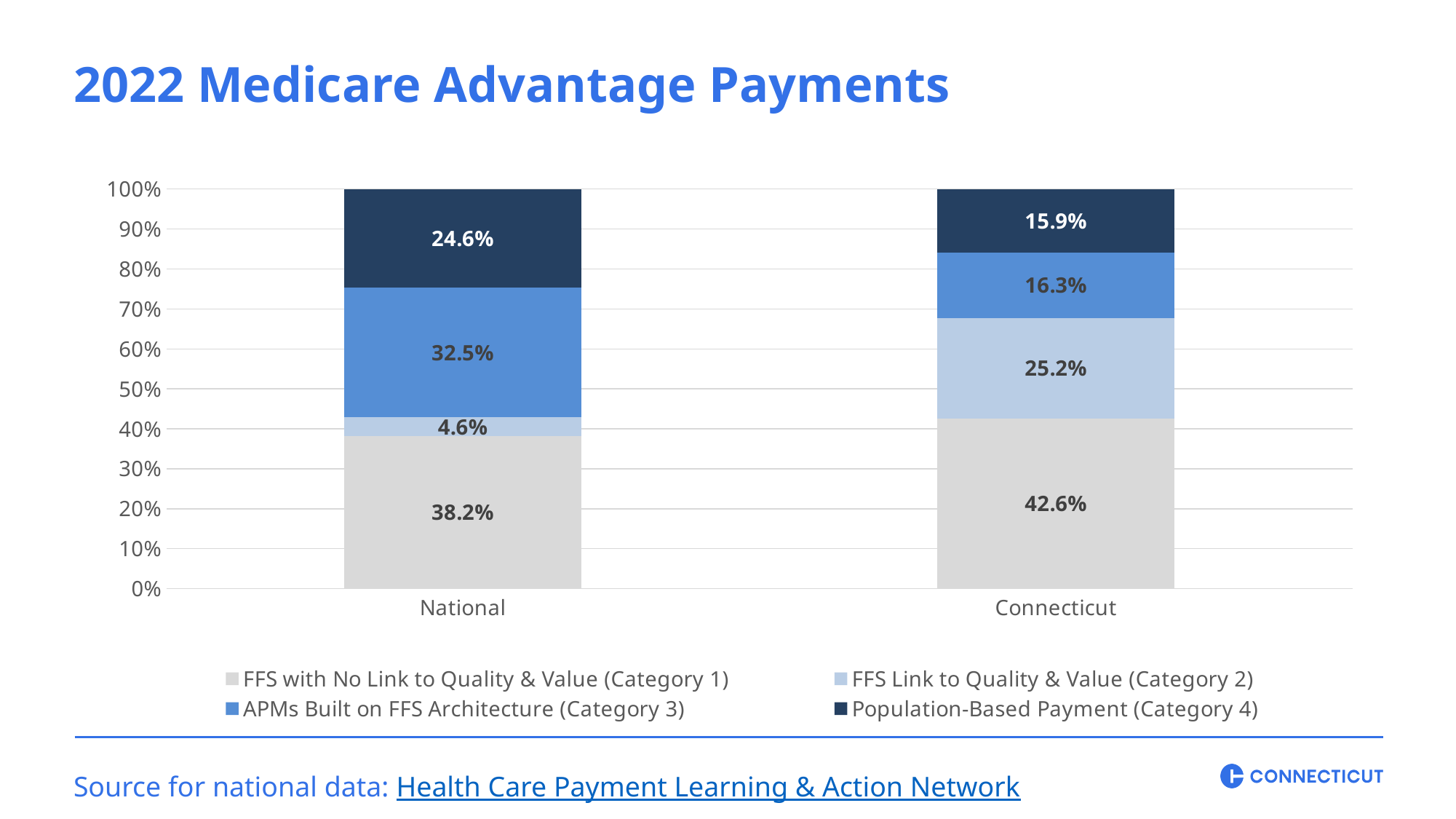
What kind of chart is shown on the slide? Stacked bar chart How many series does the legend list? 4 How many categories are shown on the x axis? 2 Which is larger: the Category 2 (FFS Link to Quality & Value) value for National or for Connecticut? Connecticut Which series has the smallest share in the National bar? FFS Link to Quality & Value (Category 2) What is the difference between the Category 3 (APMs Built on FFS Architecture) values for National and Connecticut? 16.2% What is the value for APMs Built on FFS Architecture (Category 3) for Connecticut? 16.3% What is the title of the chart? 2022 Medicare Advantage Payments What is the value for FFS Link to Quality & Value (Category 2) for National? 4.6% Which series has the largest share in the Connecticut bar? FFS with No Link to Quality & Value (Category 1) What is the value for Population-Based Payment (Category 4) for Connecticut? 15.9% What is the value for FFS with No Link to Quality & Value (Category 1) for National? 38.2%